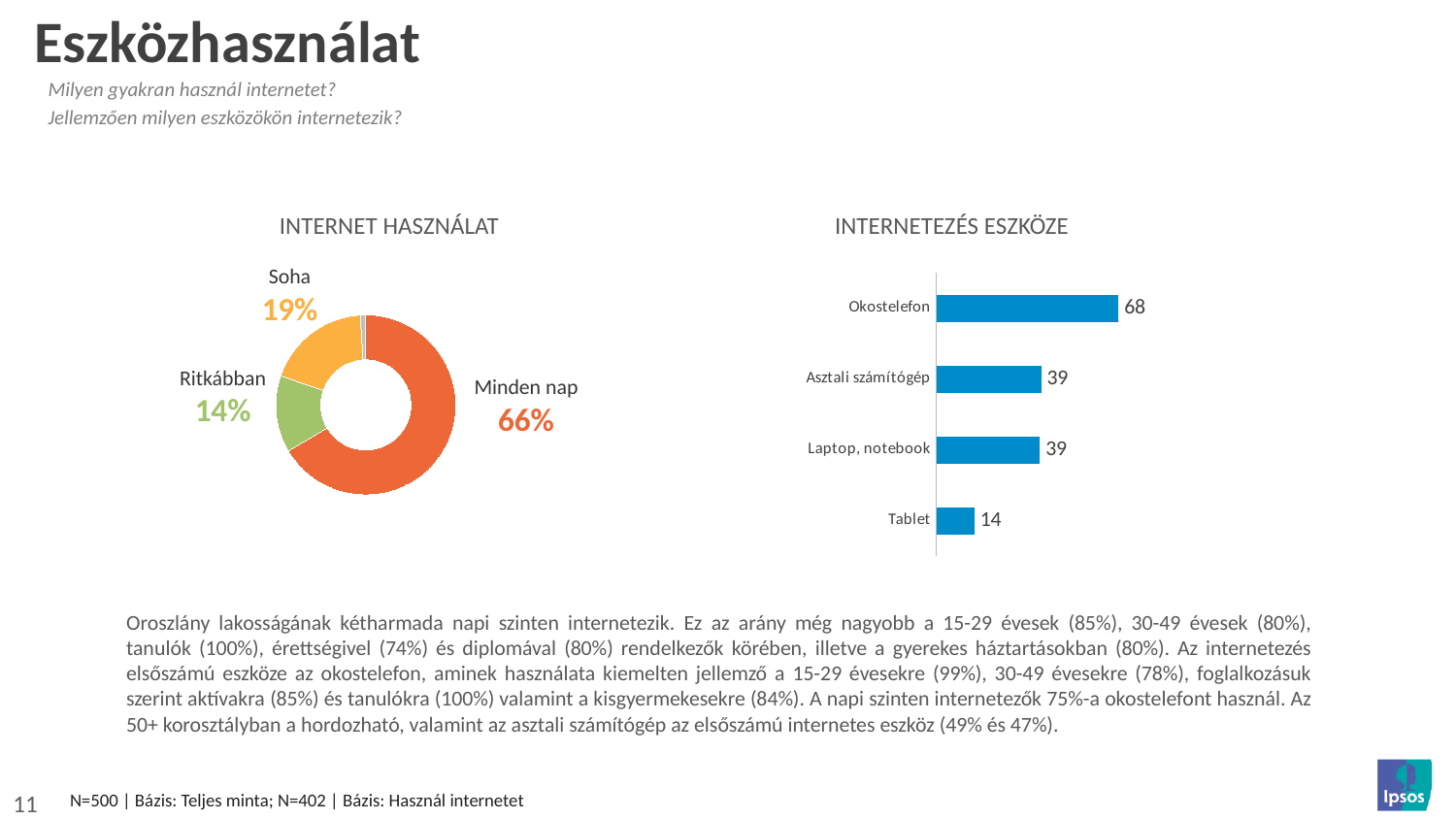
In the INTERNET HASZNÁLAT chart, which is larger, Ritkábban or Soha? Soha In the INTERNETEZÉS ESZKÖZE chart, how many categories are shown? 4 In the INTERNETEZÉS ESZKÖZE chart, what is the value for Okostelefon? 68 In the INTERNETEZÉS ESZKÖZE chart, which category has the lowest value? Tablet In the INTERNET HASZNÁLAT chart, what share is labelled Soha? 19% In the INTERNET HASZNÁLAT chart, what share is labelled Minden nap? 66% In the INTERNETEZÉS ESZKÖZE chart, which category has the highest value? Okostelefon In the INTERNETEZÉS ESZKÖZE chart, what is the value for Tablet? 14 In the INTERNETEZÉS ESZKÖZE chart, what is the difference between the values for Okostelefon and Tablet? 54 What kind of chart is the INTERNETEZÉS ESZKÖZE chart? Bar chart What kind of chart is the INTERNET HASZNÁLAT chart? Donut chart In the INTERNETEZÉS ESZKÖZE chart, what is the value for Asztali számítógép? 39